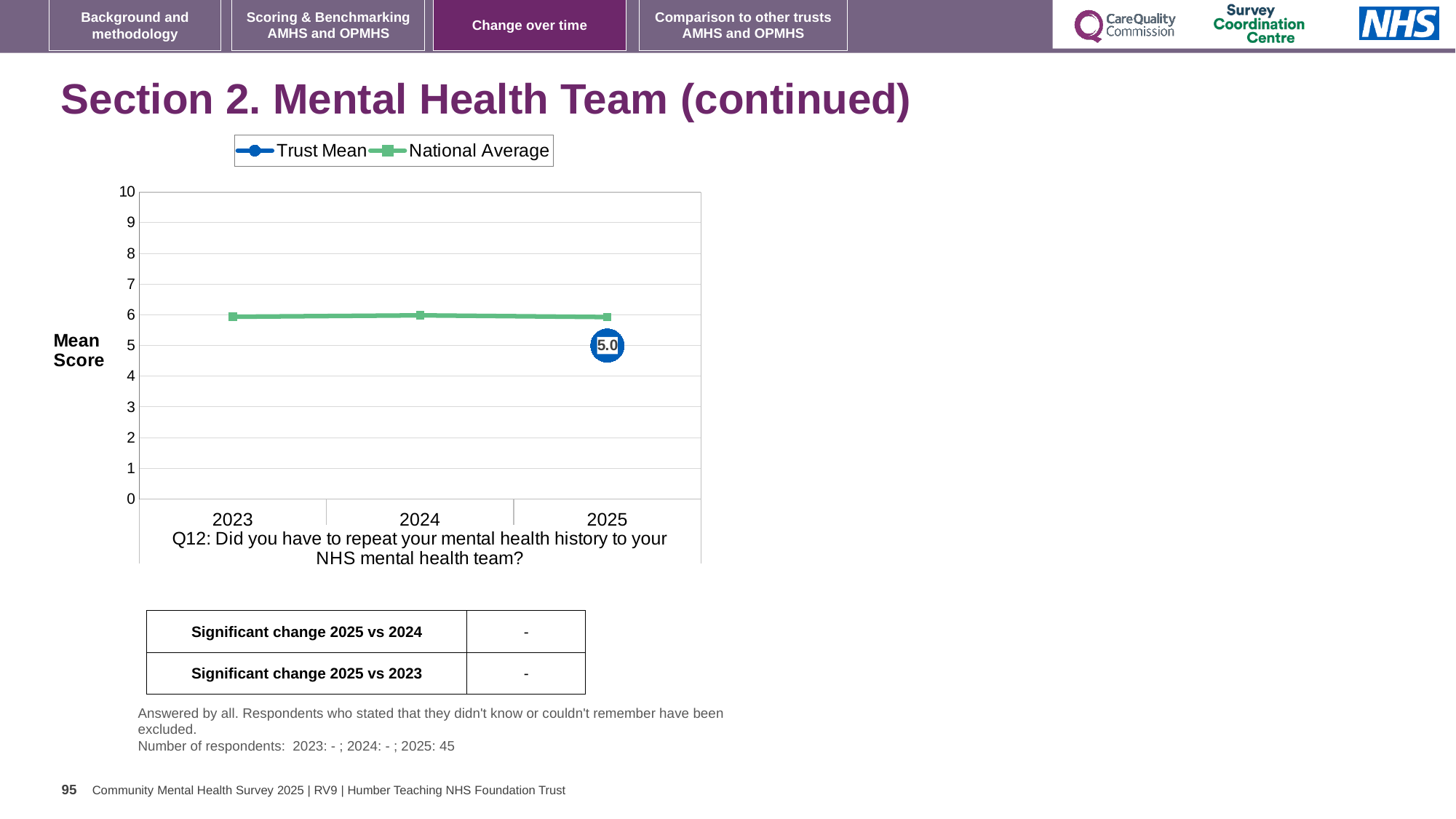
Is the Trust Mean value for 2025 greater or less than 6? less Is the National Average value for 2024 greater or less than 4? greater Is the National Average value for 2025 greater or less than 7? less How many years are shown on the x axis? 3 How many series does the legend list? 2 What kind of chart is shown on the slide? Line chart What is the label on the y axis of the chart? Mean Score In 2025, which is higher: the Trust Mean or the National Average? National Average What is the Trust Mean value for 2025? 5.0 Which series is plotted with a green line? National Average